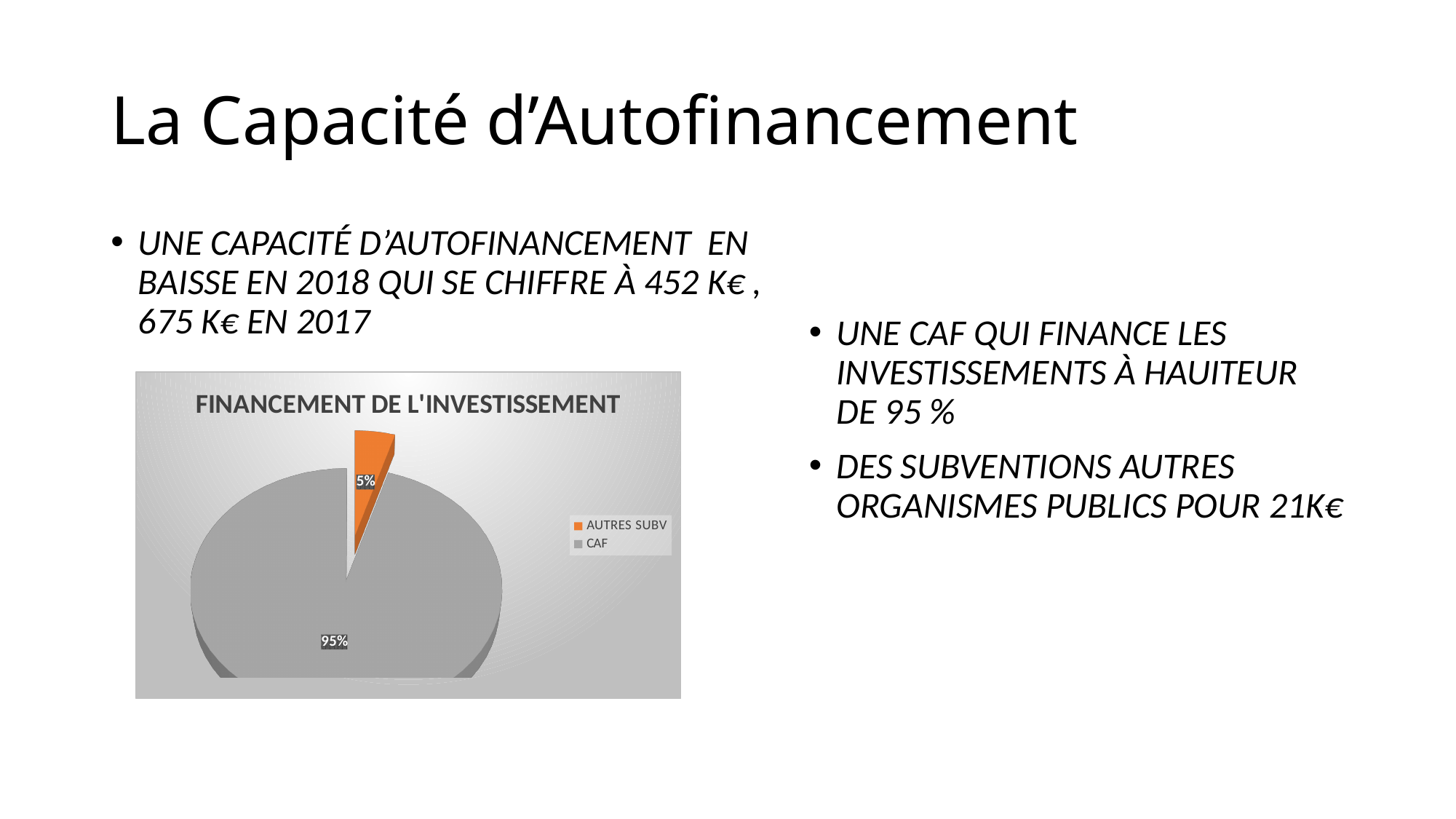
Which slice of the pie is the smallest? AUTRES SUBV What share of the pie does AUTRES SUBV represent? 5% Which is larger, the CAF slice or the AUTRES SUBV slice? CAF What kind of chart is shown on the slide? pie chart What share of the pie does CAF represent? 95% How many slices does the pie chart have? 2 What colour is the AUTRES SUBV slice? orange What is the difference in percentage points between the CAF slice and the AUTRES SUBV slice? 90 Which slice of the pie is the largest? CAF What is the title of the chart? FINANCEMENT DE L'INVESTISSEMENT How many entries does the legend list? 2